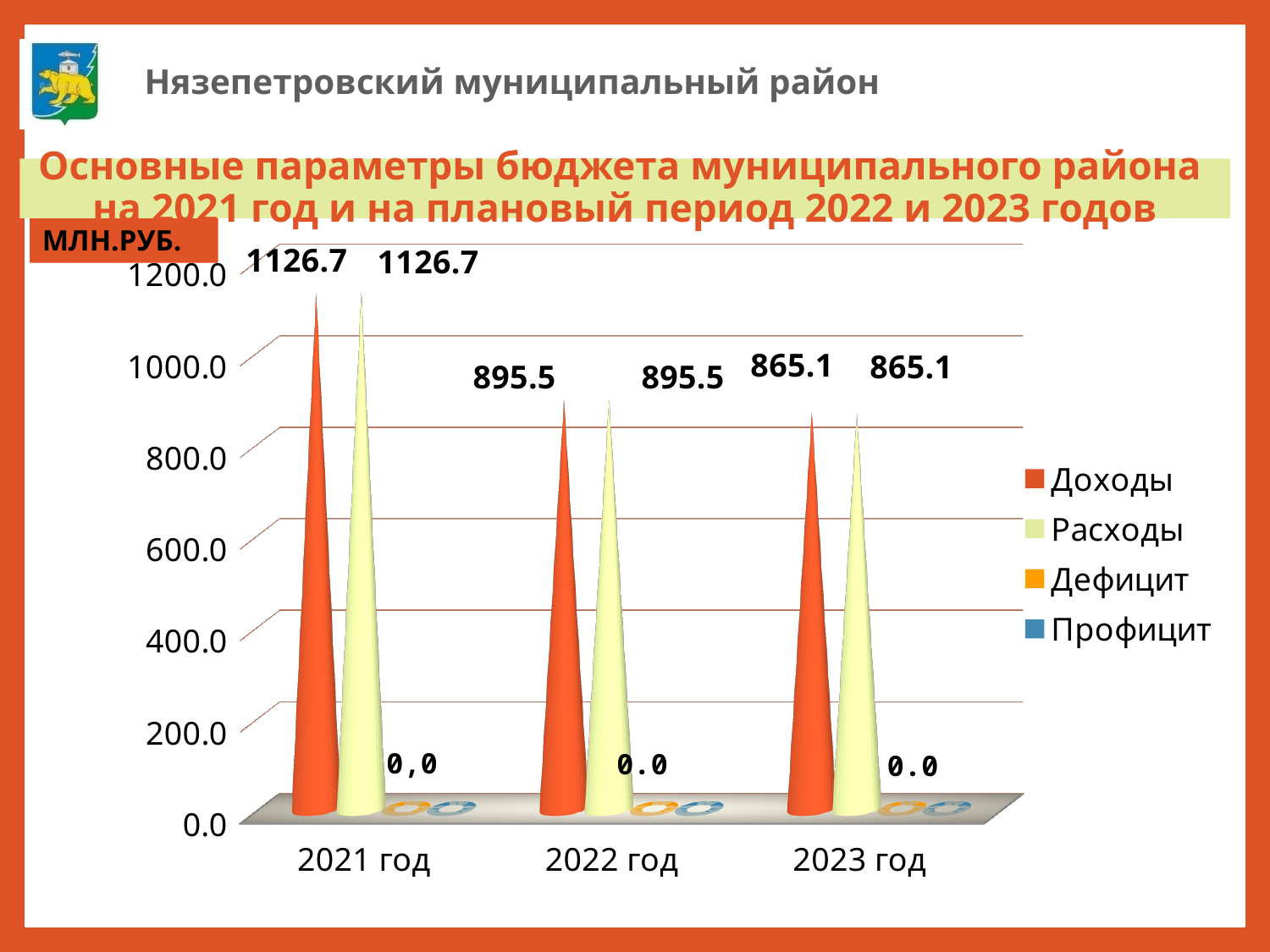
What is the value of Доходы for 2023 год? 865.1 Which is larger: Доходы in 2022 год or Доходы in 2023 год? Доходы in 2022 год What is the value of Расходы for 2022 год? 895.5 Which year has the highest value for Доходы? 2021 год What unit is indicated for the values on the chart? МЛН.РУБ. What is the difference between Доходы in 2021 год and Доходы in 2022 год? 231.2 How many years are shown on the x axis? 3 How many series does the legend list? 4 What is the value of Доходы for 2021 год? 1126.7 What is the difference between Расходы in 2022 год and Расходы in 2023 год? 30.4 Which year has the lowest value for Расходы? 2023 год Do the values for Доходы rise or fall from 2021 год to 2023 год? fall